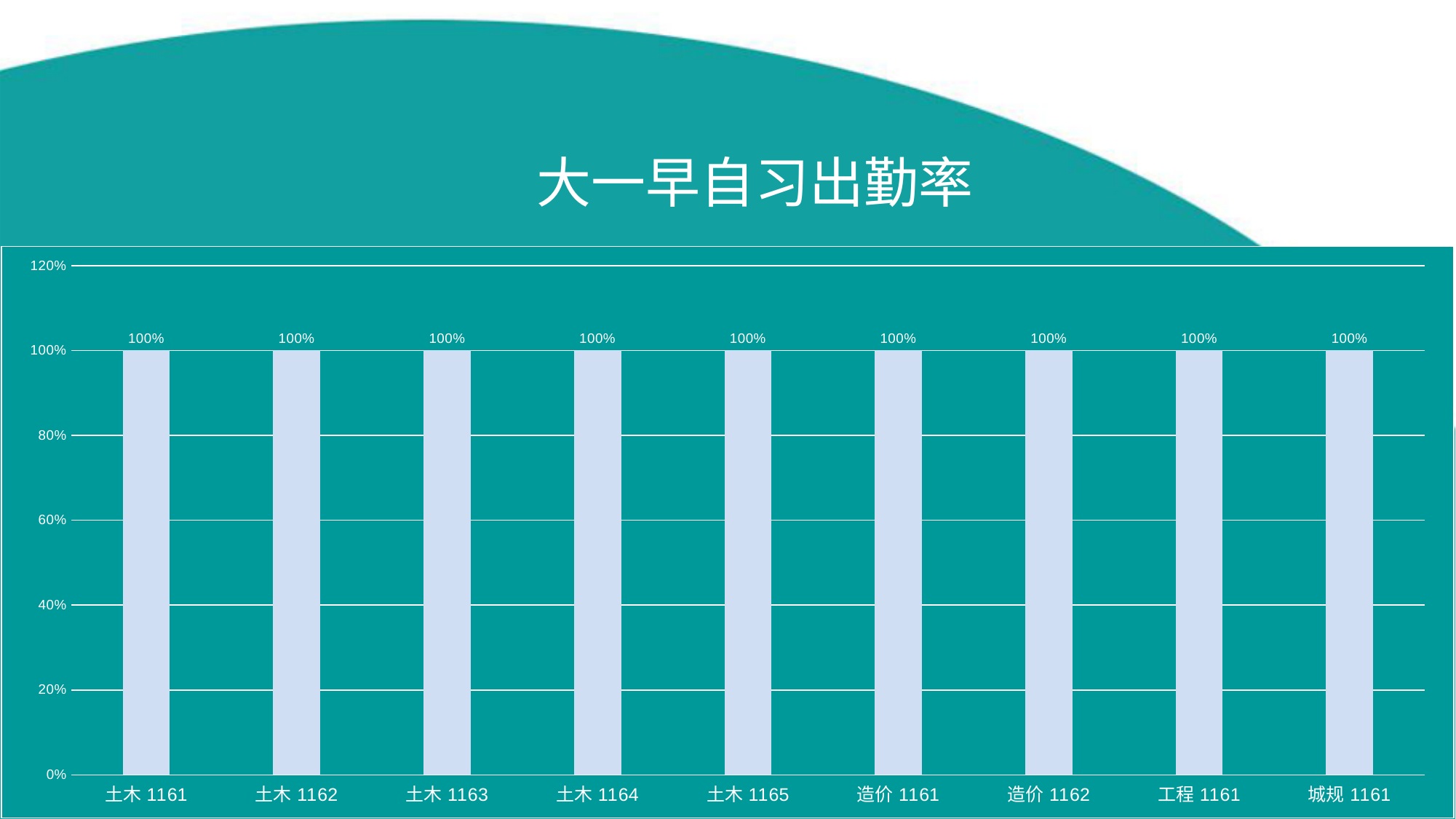
What is the difference between the values for 土木 1163 and 造价 1161? 0% Is the value for 土木 1165 greater or less than 80%? greater What is the title of the chart? 大一早自习出勤率 What is the value for 城规 1161? 100% What is the value for 土木 1161? 100% Is the value for 土木 1162 larger than, smaller than, or equal to the value for 工程 1161? equal What is the value for 造价 1162? 100% Do the values rise, fall, or stay the same across the categories from 土木 1161 to 城规 1161? stay the same What is the highest value shown on the y axis? 120% How many categories are shown on the x axis? 9 What is the value for 工程 1161? 100% What kind of chart is shown on the slide? bar chart